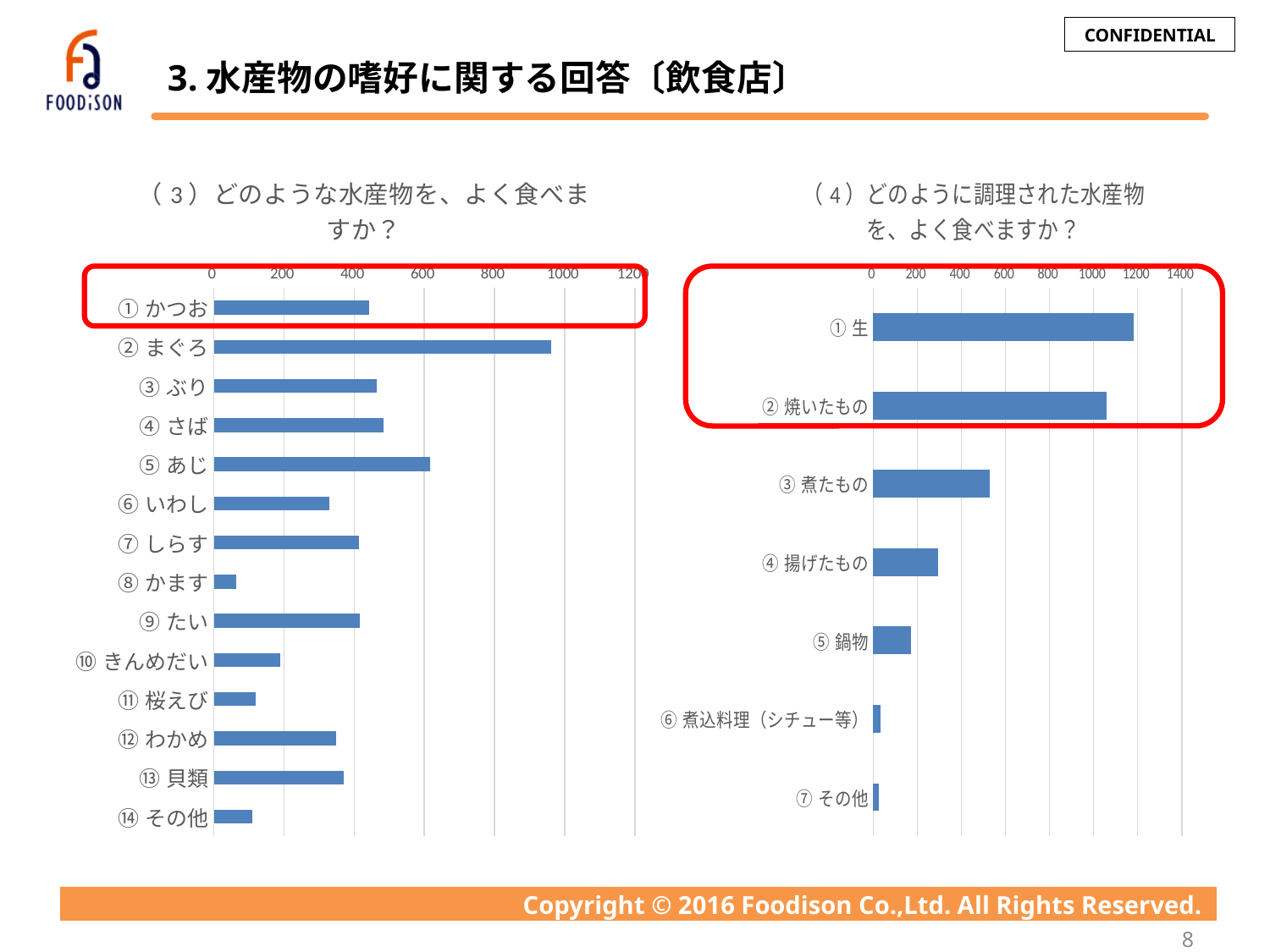
What type of chart is the right chart (4)? Bar chart In the left chart (3), is the value for ② まぐろ greater or less than 800? greater How many categories are shown in the right chart (4)? 7 In the right chart (4), which category has the highest value? ① 生 In the right chart (4), which is larger, ② 焼いたもの or ③ 煮たもの? ② 焼いたもの In the right chart (4), is the value for ③ 煮たもの greater or less than 800? less How many categories are shown in the left chart (3)? 14 In the left chart (3), which is larger, ⑤ あじ or ④ さば? ⑤ あじ In the left chart (3), which category has the longest bar? ② まぐろ In the left chart (3), which category has the shortest bar? ⑧ かます In the left chart (3), is the value for ⑧ かます greater or less than 200? less